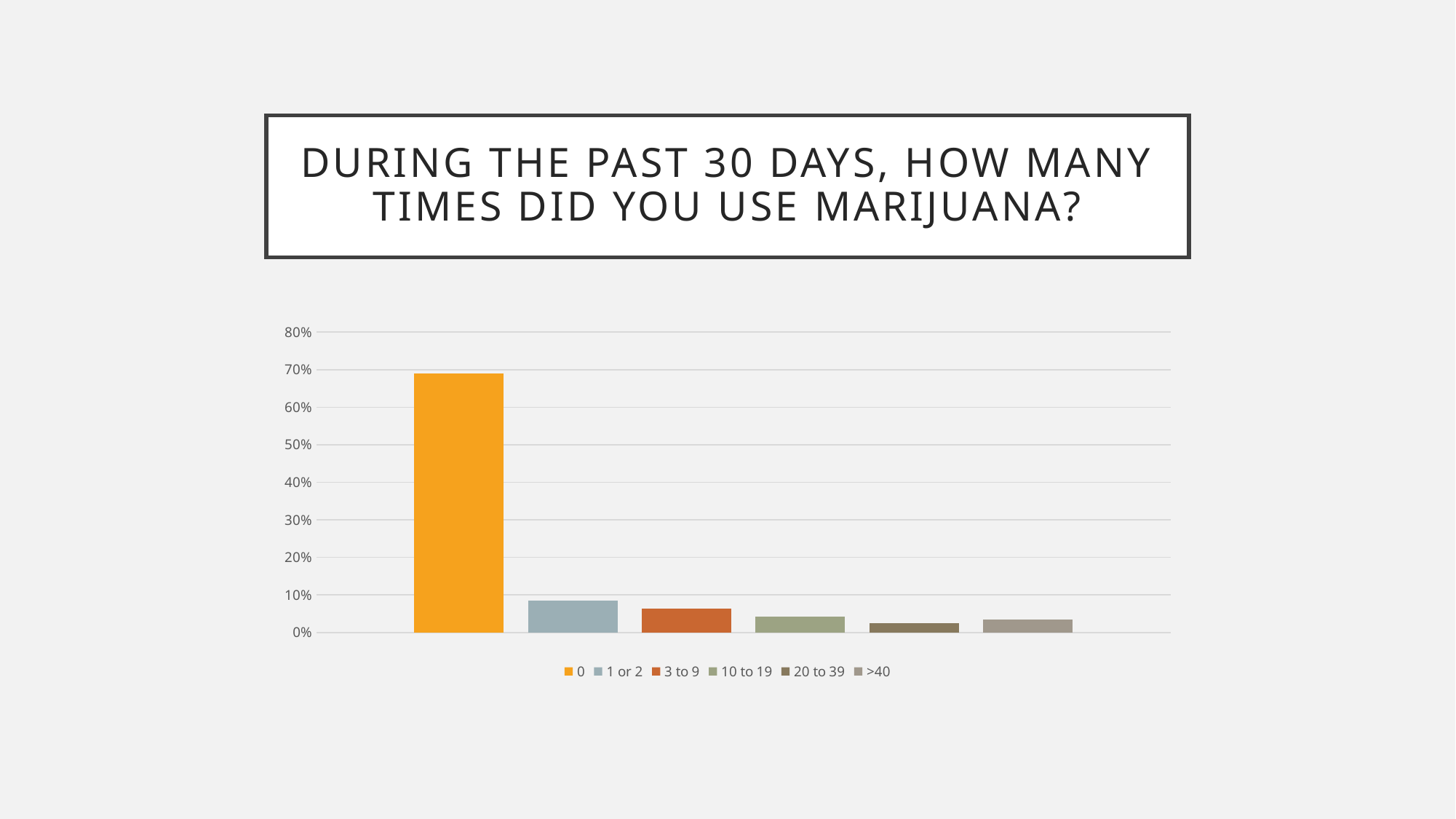
Is the value for the "0" category greater or less than 60%? greater What kind of chart is shown on the slide? bar chart What is the title of the slide? During the past 30 days, how many times did you use marijuana? Which response category has the highest value? 0 How many bars are plotted in the chart? 6 Which response category has the lowest value? 20 to 39 Which is larger, the value for "1 or 2" or the value for "3 to 9"? 1 or 2 Is the value for the "1 or 2" category greater or less than 10%? less How many series does the legend list? 6 Which is larger, the value for "20 to 39" or the value for ">40"? >40 Is the value for the "10 to 19" category greater or less than 10%? less